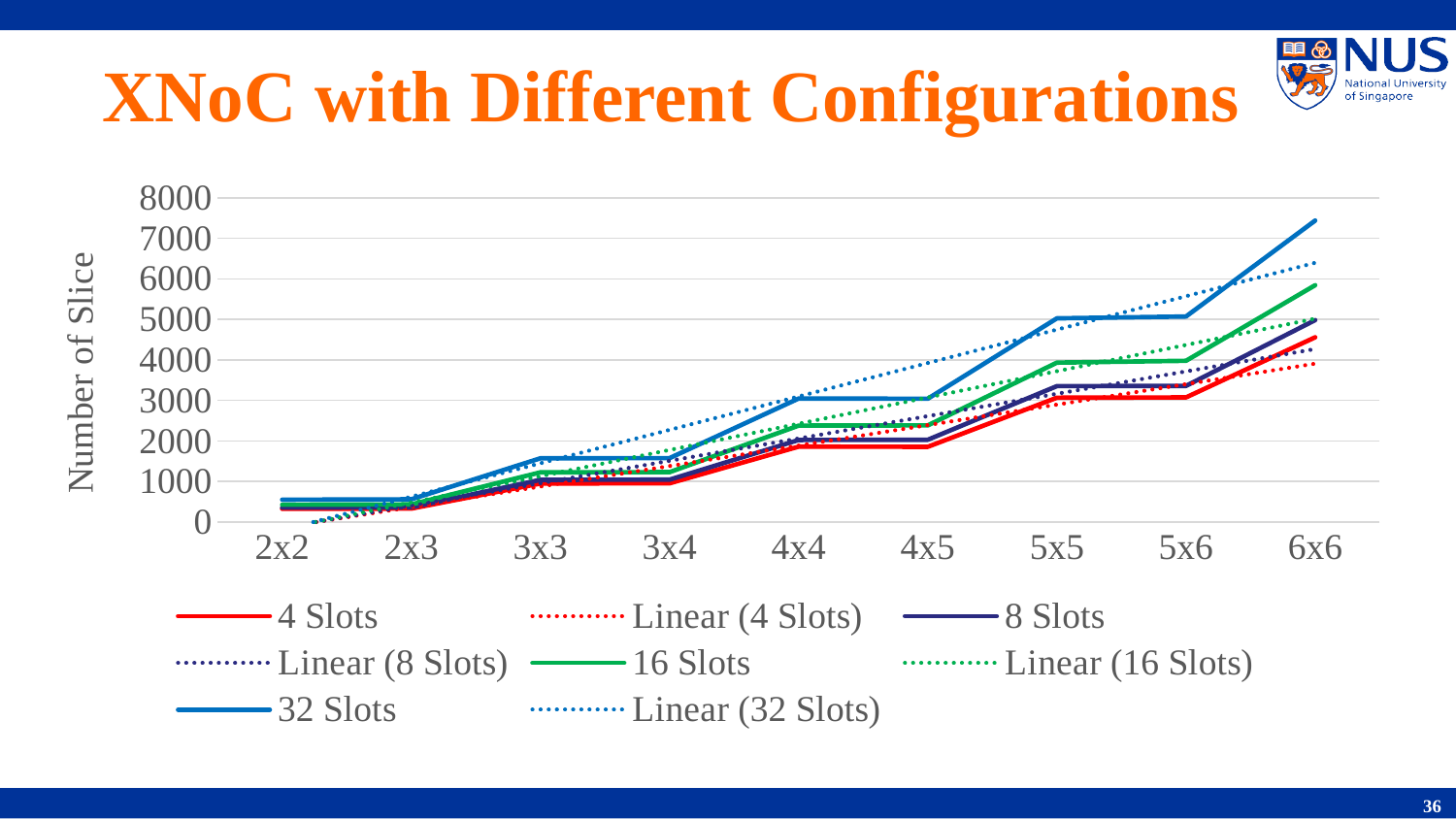
What is the label on the y axis? Number of Slice Which solid-line series has the lowest value at 6x6? 4 Slots How many configurations are shown along the x axis? 9 Do the values for 32 Slots generally rise or fall from 2x2 to 6x6? rise Is the value for 4 Slots at 4x5 greater or less than 2000? less What kind of chart is shown on the slide? line chart Is the value for 4 Slots at 6x6 greater or less than 4000? greater Is the value for 32 Slots at 6x6 greater or less than 7000? greater At 5x5, which is larger: the value for 32 Slots or the value for 4 Slots? 32 Slots Which series has the highest value at 6x6? 32 Slots How many series does the legend list? 8